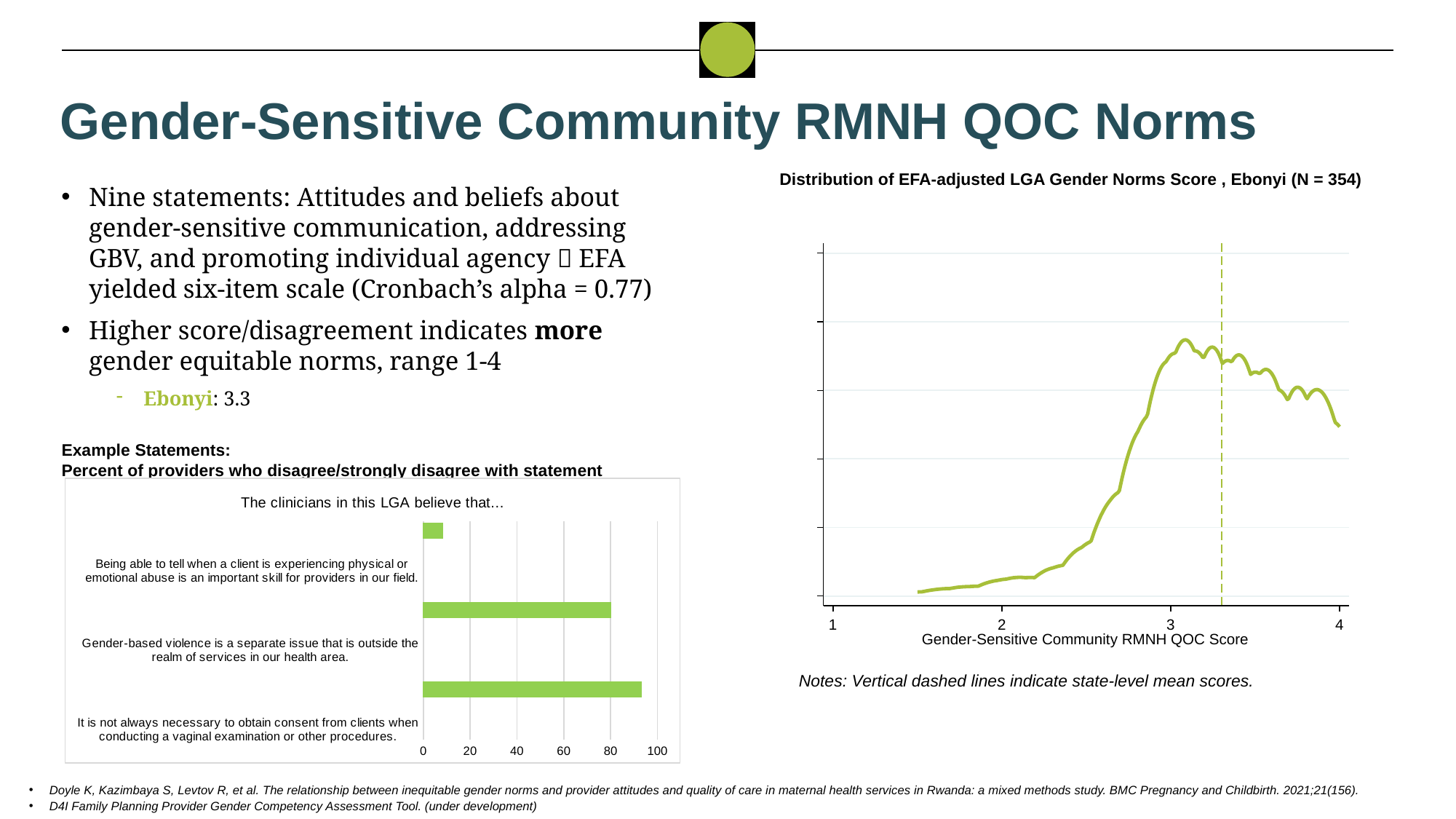
In the bar chart on the left, is the value for 'Being able to tell when a client is experiencing physical or emotional abuse is an important skill for providers in our field' greater or less than 20? less What type of chart is the chart titled 'Distribution of EFA-adjusted LGA Gender Norms Score, Ebonyi (N = 354)'? line chart What is the maximum value shown on the horizontal axis of the bar chart on the left? 100 In the bar chart on the left, which statement has the highest percent of providers who disagree/strongly disagree? It is not always necessary to obtain consent from clients when conducting a vaginal examination or other procedures. In the bar chart on the left, is the value for 'Gender-based violence is a separate issue that is outside the realm of services in our health area' greater or less than 60? greater In the bar chart on the left, which statement has the lowest percent of providers who disagree/strongly disagree? Being able to tell when a client is experiencing physical or emotional abuse is an important skill for providers in our field. In the chart titled 'Distribution of EFA-adjusted LGA Gender Norms Score, Ebonyi (N = 354)', does the line rise or fall between scores of 2 and 3? rise What type of chart is the chart titled 'Example Statements: Percent of providers who disagree/strongly disagree with statement'? bar chart How many statements (bars) are shown in the bar chart on the left of the slide? 3 In the bar chart on the left, is the value for 'It is not always necessary to obtain consent from clients when conducting a vaginal examination or other procedures' greater or less than 80? greater In the chart titled 'Distribution of EFA-adjusted LGA Gender Norms Score, Ebonyi (N = 354)', what is the label of the x axis? Gender-Sensitive Community RMNH QOC Score In the bar chart on the left, which has a larger value: the statement about gender-based violence being a separate issue, or the statement about consent for vaginal examinations? It is not always necessary to obtain consent from clients when conducting a vaginal examination or other procedures.